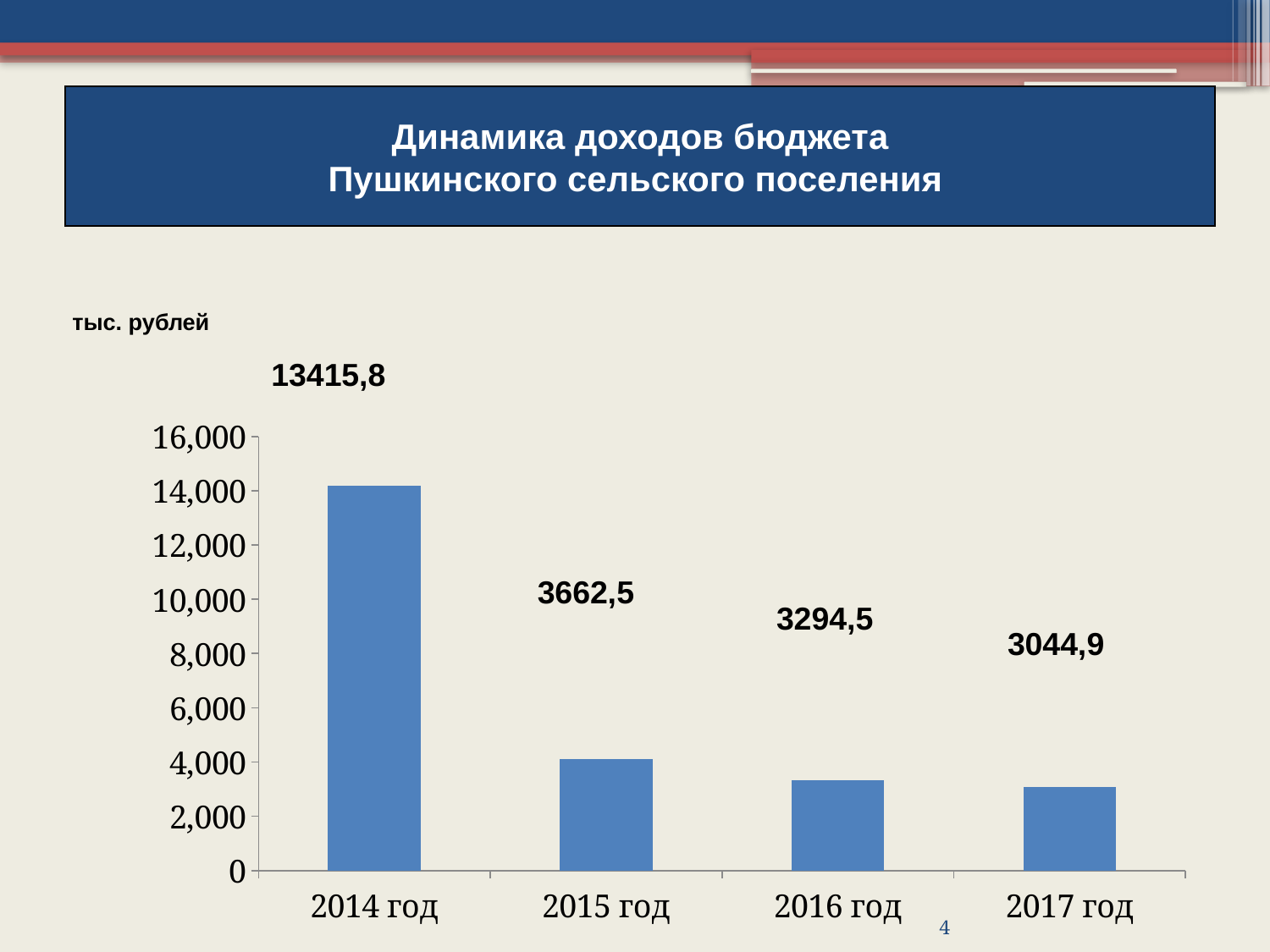
Do the values rise or fall from 2014 год to 2017 год? fall Is the value for 2014 год greater or less than 12,000? greater What is the value for 2015 год? 3662,5 Which year has the highest value? 2014 год How many years are shown on the x axis? 4 Which is larger, the value for 2015 год or the value for 2016 год? 2015 год What is the difference between the values for 2014 год and 2015 год? 9753,3 What is the difference between the values for 2016 год and 2017 год? 249,6 What is the value for 2016 год? 3294,5 What is the value for 2017 год? 3044,9 Which year has the lowest value? 2017 год What is the value for 2014 год? 13415,8